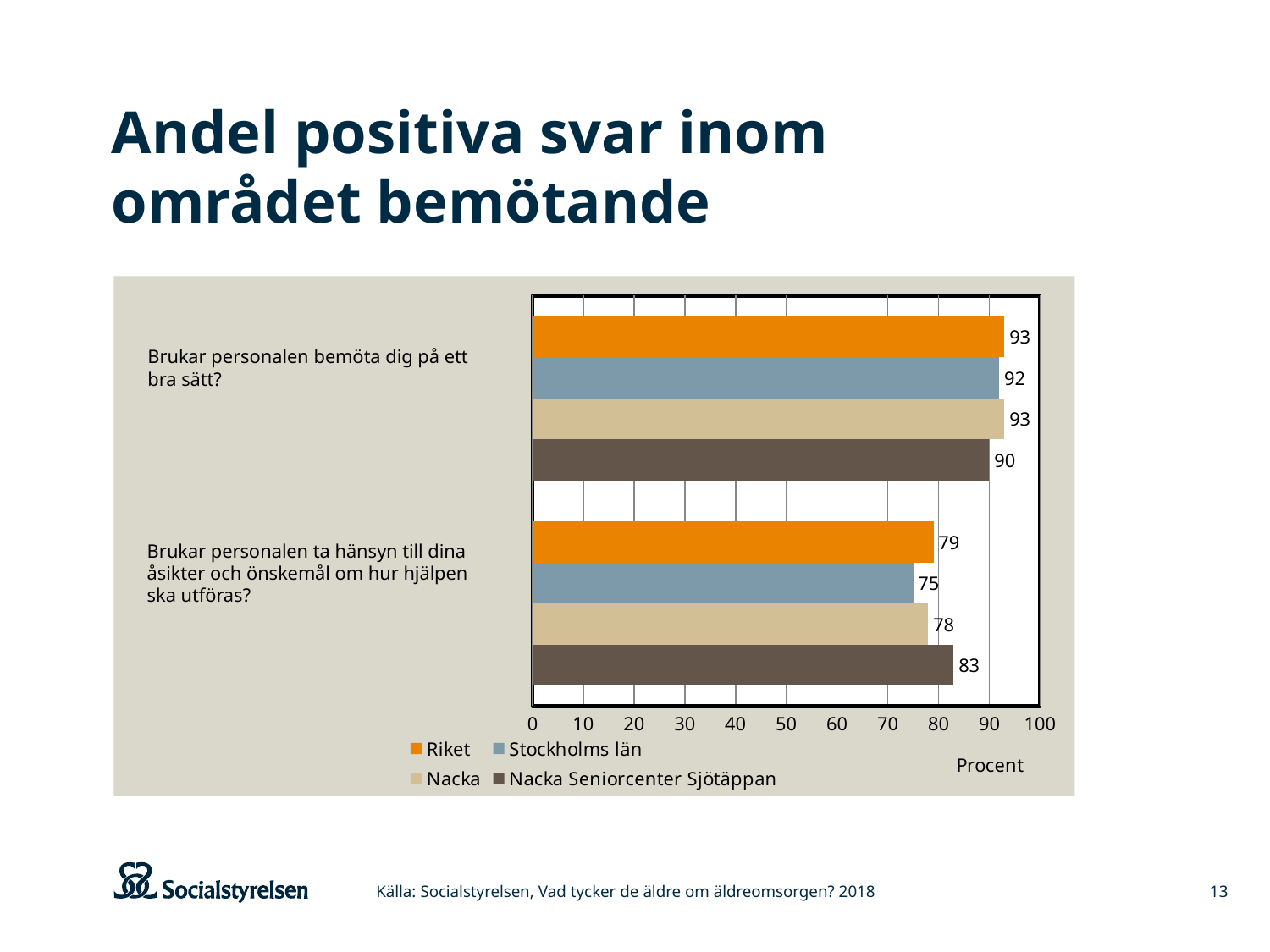
What kind of chart is shown on the slide? bar chart For "Brukar personalen bemöta dig på ett bra sätt?", which is larger: the value for Nacka or the value for Nacka Seniorcenter Sjötäppan? Nacka What is the difference between the Nacka Seniorcenter Sjötäppan value and the Stockholms län value for "Brukar personalen ta hänsyn till dina åsikter och önskemål om hur hjälpen ska utföras?"? 8 Is the value for Riket for "Brukar personalen ta hänsyn till dina åsikter och önskemål om hur hjälpen ska utföras?" greater or less than 70? greater Which series has the highest value for "Brukar personalen ta hänsyn till dina åsikter och önskemål om hur hjälpen ska utföras?"? Nacka Seniorcenter Sjötäppan Which series has the lowest value for "Brukar personalen ta hänsyn till dina åsikter och önskemål om hur hjälpen ska utföras?"? Stockholms län How many series does the legend list? 4 What is the value for Nacka Seniorcenter Sjötäppan for "Brukar personalen bemöta dig på ett bra sätt?"? 90 What is the value for Stockholms län for "Brukar personalen ta hänsyn till dina åsikter och önskemål om hur hjälpen ska utföras?"? 75 How many question categories are plotted on the chart? 2 What label is shown on the horizontal axis of the chart? Procent What is the value for Riket for "Brukar personalen bemöta dig på ett bra sätt?"? 93